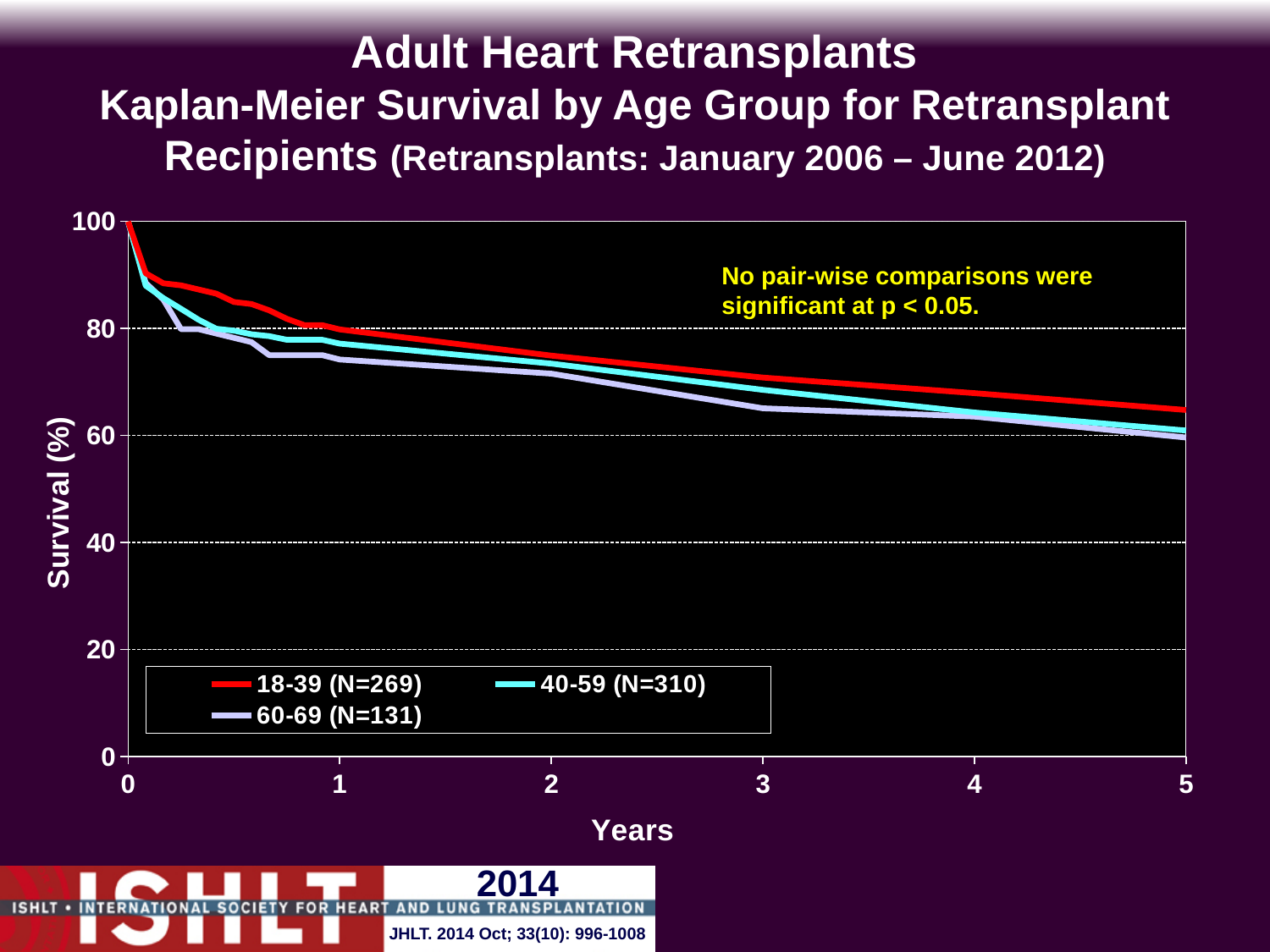
Is the survival for the 18-39 group at year 5 greater or less than 60? greater Is the survival for the 40-59 group at year 3 greater or less than 60? greater What kind of chart is shown on the slide? line chart What is the N for the 40-59 age group shown in the legend? N=310 What is the survival (%) for all age groups at year 0? 100 How many series does the legend list? 3 At year 3, which group has higher survival: 18-39 or 60-69? 18-39 Do the survival curves rise or fall as years increase? fall What is the label of the x axis? Years Which age group has the lowest survival at year 1? 60-69 Is the survival for the 60-69 group at year 1 greater or less than 80? less Which age group has the highest survival at year 3? 18-39